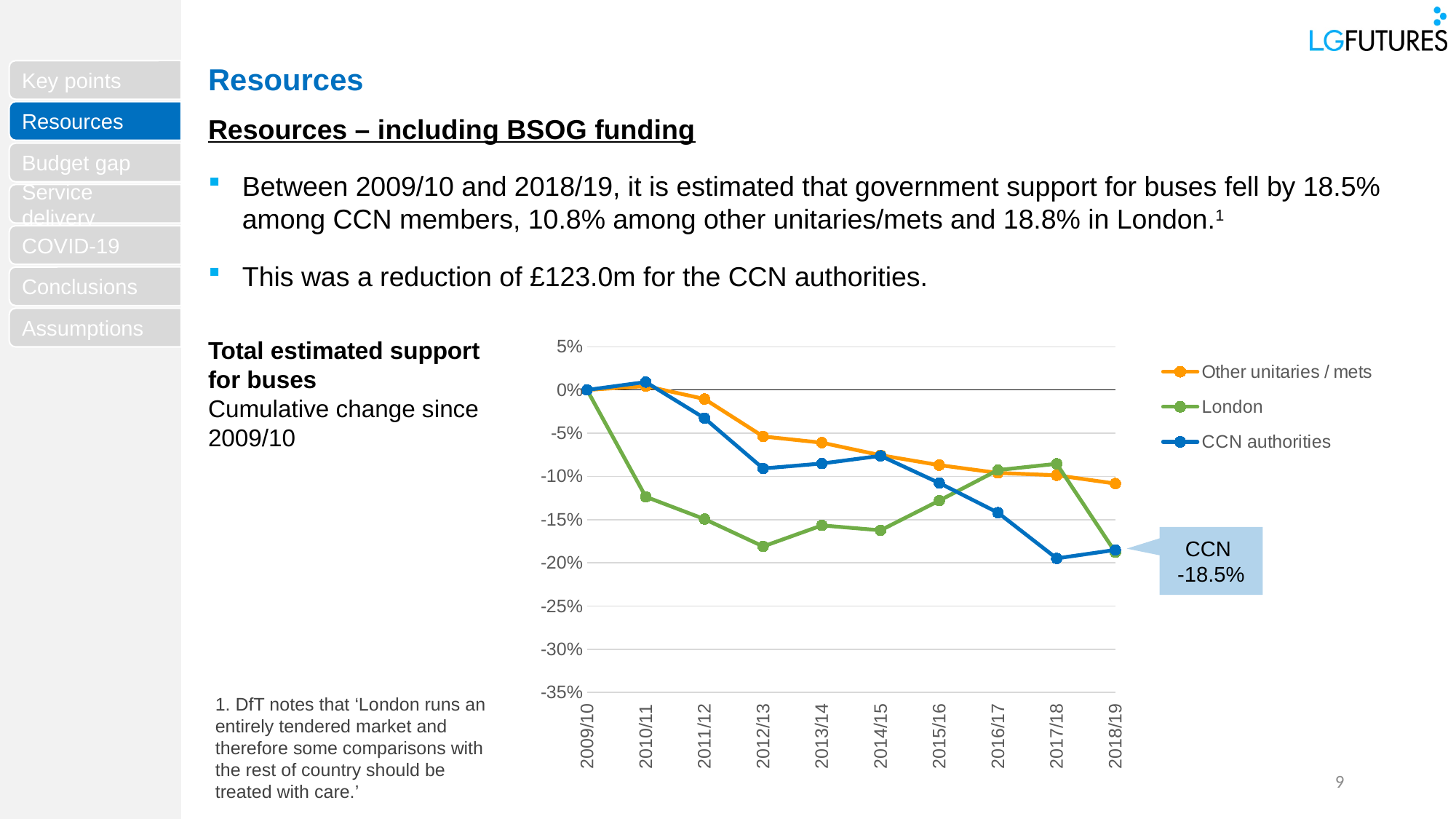
Is the value for London in 2012/13 greater or less than -15%? less Which colour is used for the London series in the chart? green Is the value for Other unitaries / mets in 2012/13 greater or less than -10%? greater In which year does the CCN authorities line reach its lowest point? 2017/18 What kind of chart is shown on the slide? line chart How many financial years are plotted along the x axis of the chart? 10 Is the value for CCN authorities in 2017/18 greater or less than -15%? less In 2018/19, which series has the higher value: Other unitaries / mets or CCN authorities? Other unitaries / mets In 2014/15, which series has the lower value: London or Other unitaries / mets? London What is the cumulative change for CCN authorities in 2018/19 according to the chart's callout? -18.5% Does the CCN authorities line generally rise or fall from 2009/10 to 2018/19? fall How many series does the chart legend list? 3